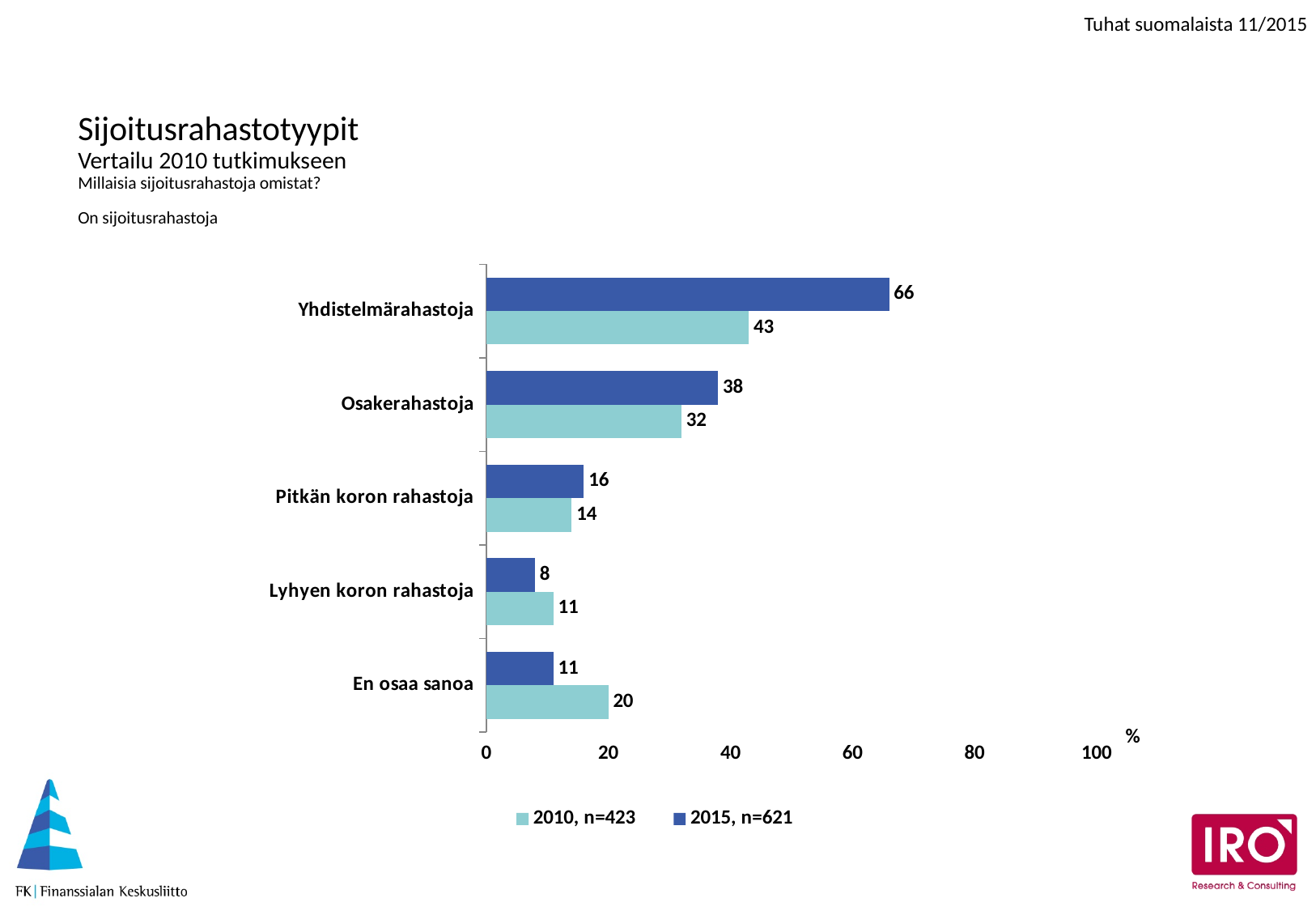
How many series does the legend list? 2 How many categories are shown on the chart? 5 What is the 2015 value for Yhdistelmärahastoja? 66 Which category has the lowest 2015 value? Lyhyen koron rahastoja Which category has the highest 2015 value? Yhdistelmärahastoja Is the 2015 value for Osakerahastoja greater or less than 40? less What kind of chart is shown on the slide? bar chart What is the difference between the 2015 and 2010 values for Yhdistelmärahastoja? 23 What is the 2010 value for En osaa sanoa? 20 What is the 2010 value for Osakerahastoja? 32 Which is larger for Lyhyen koron rahastoja, the 2010 value or the 2015 value? 2010 What is the sample size (n) for the 2015 series in the legend? 621